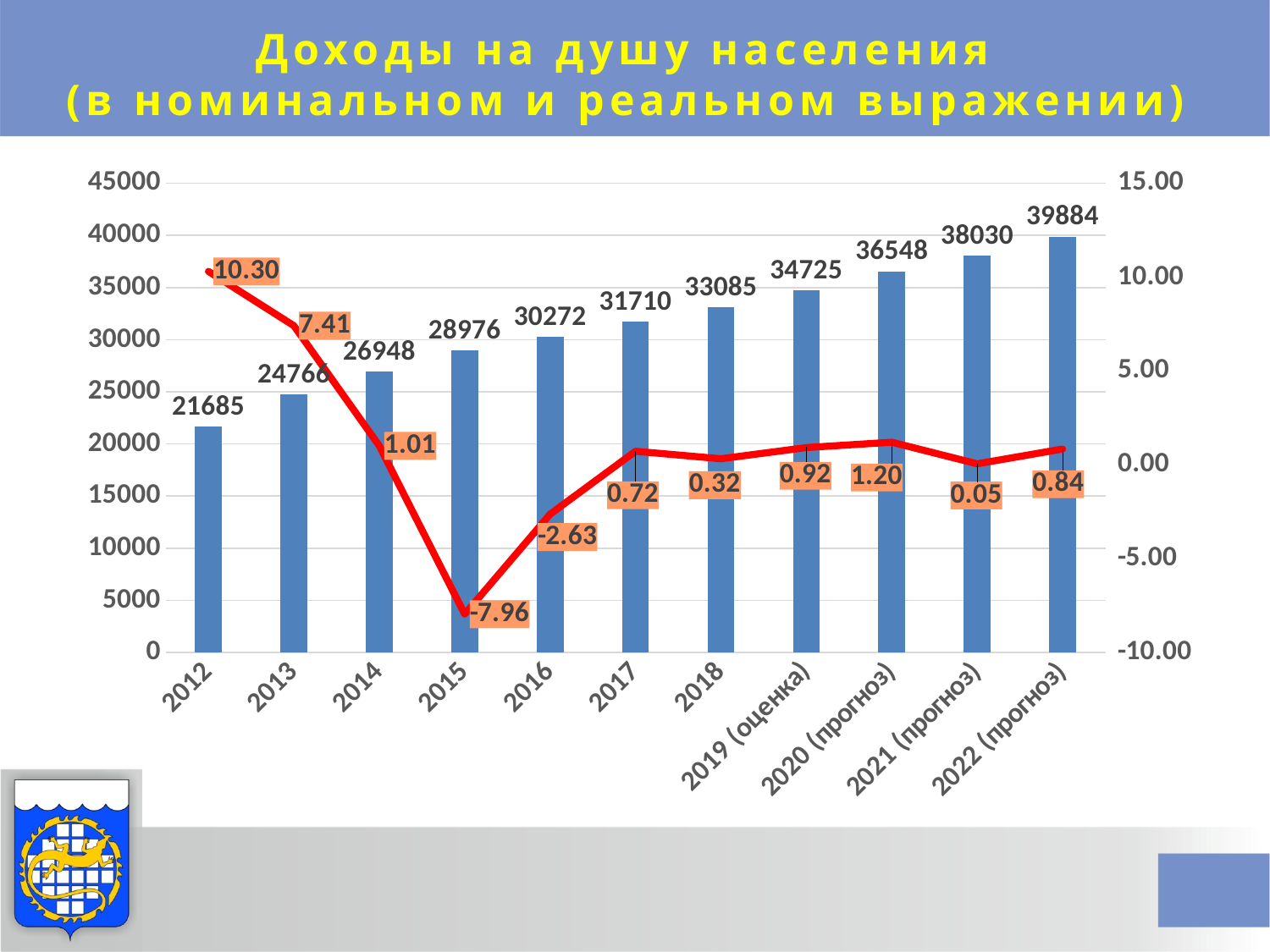
What is the title of the chart? Доходы на душу населения (в номинальном и реальном выражении) Which is larger, the red line value for 2013 or for 2014? 2013 What value does the red line show for 2015? -7.96 What value does the red line show for 2020 (прогноз)? 1.20 Do the bar values rise or fall from 2012 to 2022 (прогноз)? rise What is the difference between the bar values for 2022 (прогноз) and 2012? 18199 Which year has the highest bar value? 2022 (прогноз) What is the bar value for 2012? 21685 Which year has the lowest value on the red line? 2015 What kind of chart is shown on the slide? Combined bar and line chart What is the bar value for 2019 (оценка)? 34725 How many years are shown on the x axis? 11